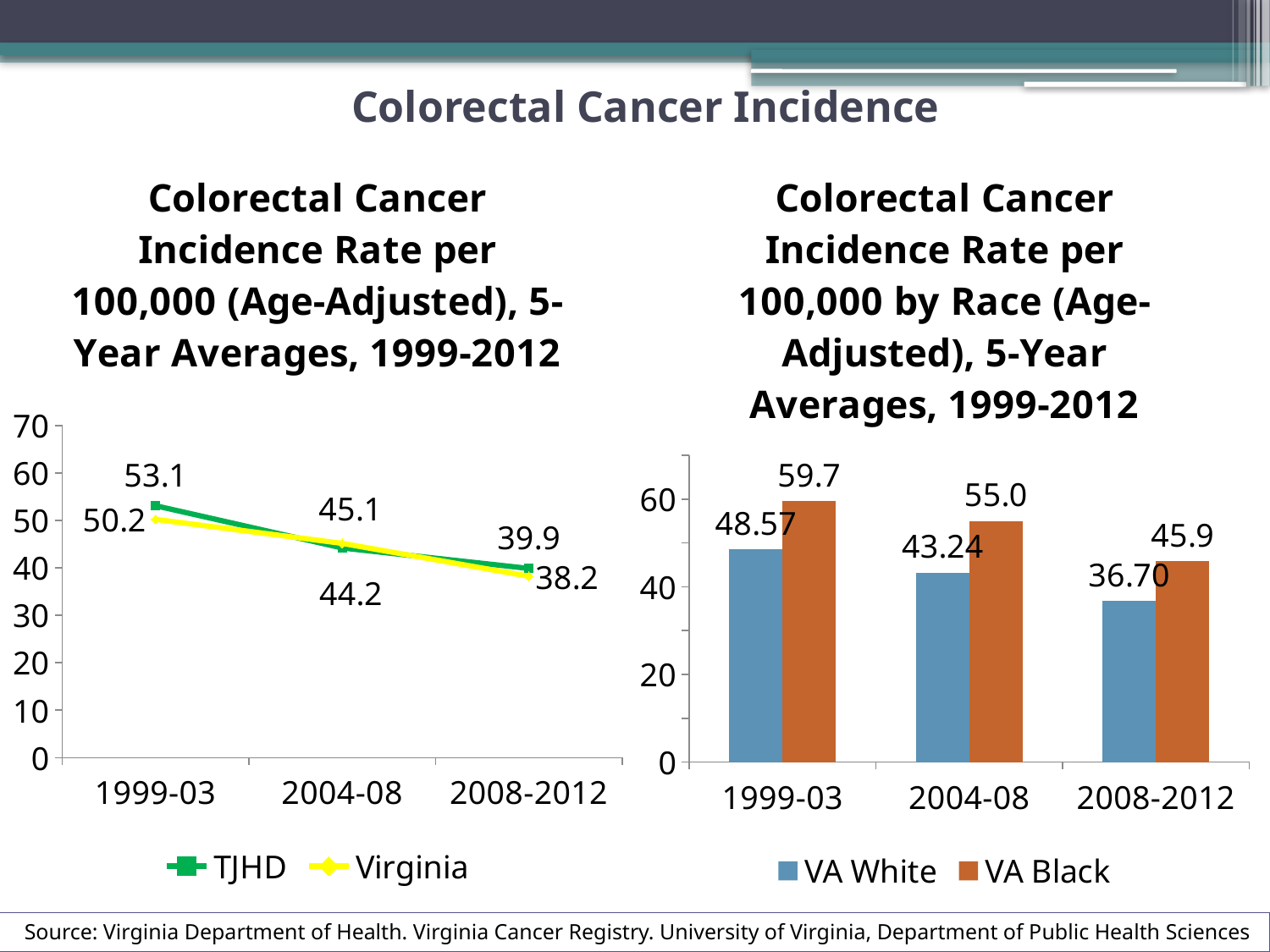
How many series does the legend of the right chart list? 2 In the right chart, which period has the lowest VA Black value? 2008-2012 In the left chart, what is the difference between the TJHD and Virginia values for 1999-03? 2.9 In the left chart, what is the TJHD value for 1999-03? 53.1 In the right chart, which is larger for 2004-08, VA White or VA Black? VA Black In the left chart, does the TJHD series rise or fall across the periods? fall In the right chart, what is the VA White value for 2008-2012? 36.70 In the left chart, what is the Virginia value for 2008-2012? 38.2 In the left chart, what is the TJHD value for 2004-08? 44.2 What kind of chart is the left chart? line chart What kind of chart is the right chart? bar chart In the right chart, what is the VA Black value for 1999-03? 59.7